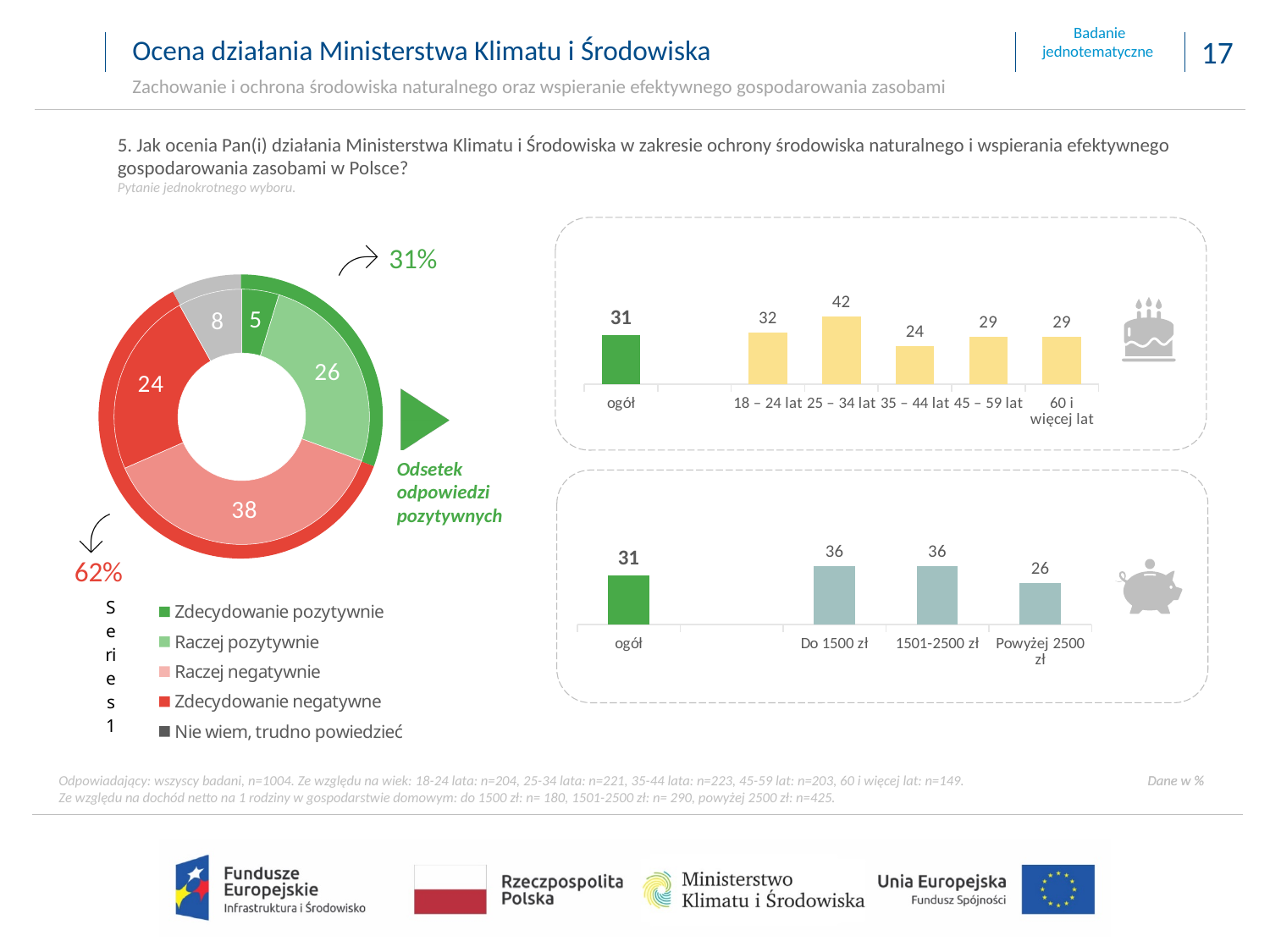
In the top-right bar chart by age, which age group has the lowest value? 35 – 44 lat In the donut chart on the left, what is the value for "Raczej negatywnie"? 38 In the top-right bar chart by age, what is the value for "25 – 34 lat"? 42 In the bottom-right bar chart by income, what is the value for "Powyżej 2500 zł"? 26 What type of chart is the bottom-right chart by income? Bar chart In the donut chart on the left, which category has the smallest slice? Zdecydowanie pozytywnie In the top-right bar chart by age, how many bars are plotted? 6 In the top-right bar chart by age, what is the difference between the values for "25 – 34 lat" and "35 – 44 lat"? 18 In the donut chart on the left, what is the value for "Zdecydowanie pozytywnie"? 5 How many entries does the legend of the donut chart on the left list? 5 In the donut chart on the left, which category has the largest slice? Raczej negatywnie In the bottom-right bar chart by income, which is larger: the value for "Do 1500 zł" or for "Powyżej 2500 zł"? Do 1500 zł